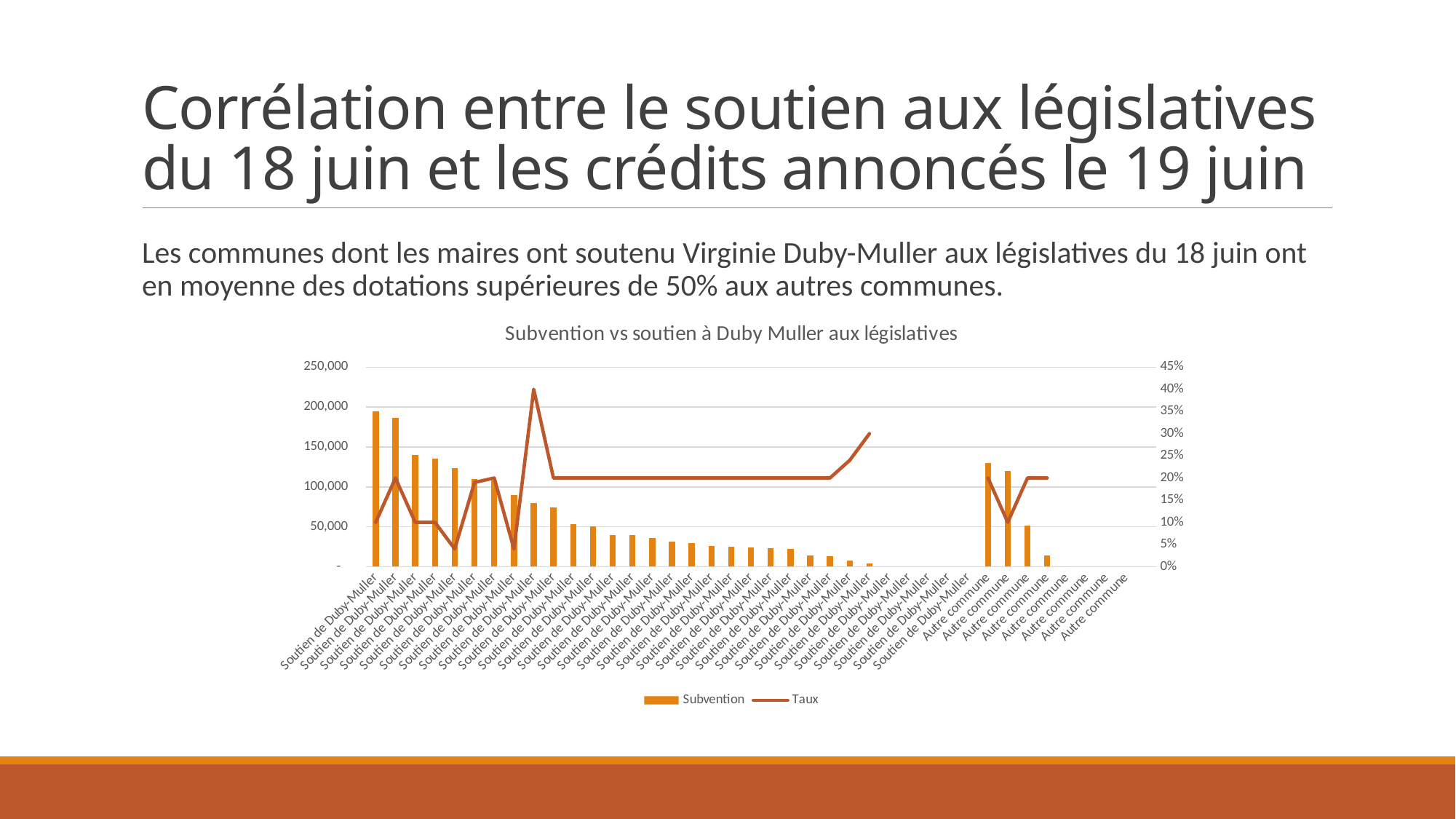
Which series in the chart is drawn as a line? Taux How many series does the legend of the chart list? 2 Do the Subvention bars for the 'Soutien de Duby-Muller' categories generally rise or fall from left to right? fall Is the highest point of the Taux line greater or less than 35%? greater What is the title of the chart? Subvention vs soutien à Duby Muller aux législatives Is the Subvention value of the leftmost bar greater or less than 150,000? greater Is the tallest Subvention bar among the 'Autre commune' categories greater or less than 100,000? greater What is the maximum value shown on the left vertical axis? 250,000 What is the maximum value shown on the right vertical axis? 45% Which is larger: the Subvention value of the leftmost 'Soutien de Duby-Muller' bar or the tallest 'Autre commune' bar? The leftmost 'Soutien de Duby-Muller' bar What kind of chart is shown on the slide? A combined bar and line chart